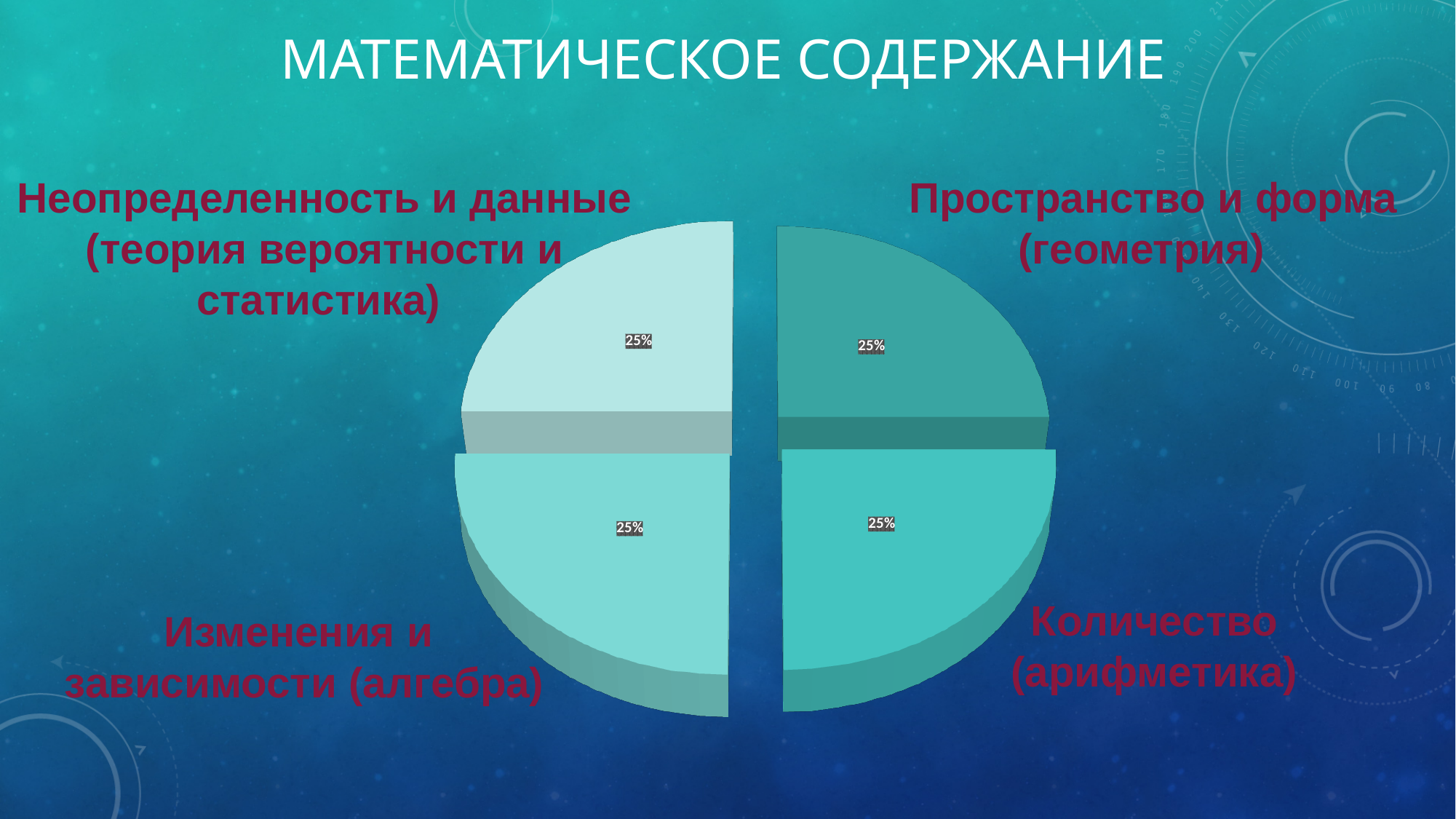
What share of the pie does the slice labelled "Изменения и зависимости (алгебра)" represent? 25% How many slices does the pie chart have? 4 What is the combined share of the slices "Пространство и форма (геометрия)" and "Количество (арифметика)"? 50% What is the difference between the share for "Изменения и зависимости (алгебра)" and the share for "Количество (арифметика)"? 0% What share of the pie does the slice labelled "Неопределенность и данные (теория вероятности и статистика)" represent? 25% What value is printed on the bottom-right slice of the pie chart? 25% What value is printed on the top-left slice of the pie chart? 25% What kind of chart is shown on the slide? pie chart Which slice of the pie chart is the lightest in colour? Неопределенность и данные (теория вероятности и статистика) What share of the pie does the slice labelled "Пространство и форма (геометрия)" represent? 25% What is the title of the slide containing the pie chart? МАТЕМАТИЧЕСКОЕ СОДЕРЖАНИЕ